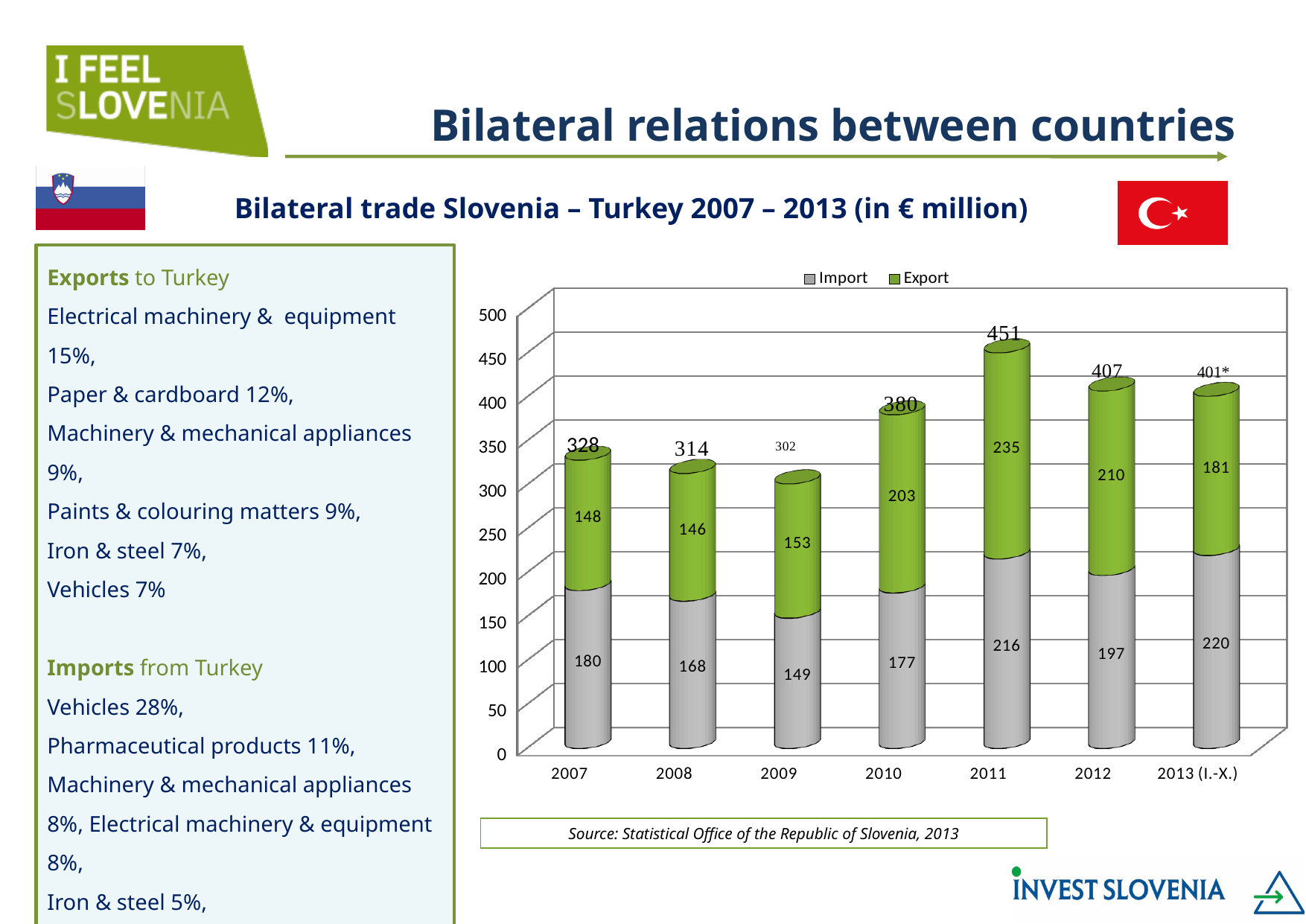
What is the Export value for 2010? 203 What kind of chart is shown on the slide? Stacked bar chart Did the total bilateral trade rise or fall from 2009 to 2011? Rise Is the Import value larger than the Export value in 2013 (I.-X.)? Yes, Import (220) is larger than Export (181) What is the difference between the Export and Import values in 2011? 19 How many series does the legend list? 2 Which colour represents Export in the chart? Green Which year has the lowest Import value? 2009 How many years (categories) are shown on the x axis? 7 Which year has the highest Export value? 2011 What is the total of the stacked bar for 2012? 407 What is the Import value for 2011? 216